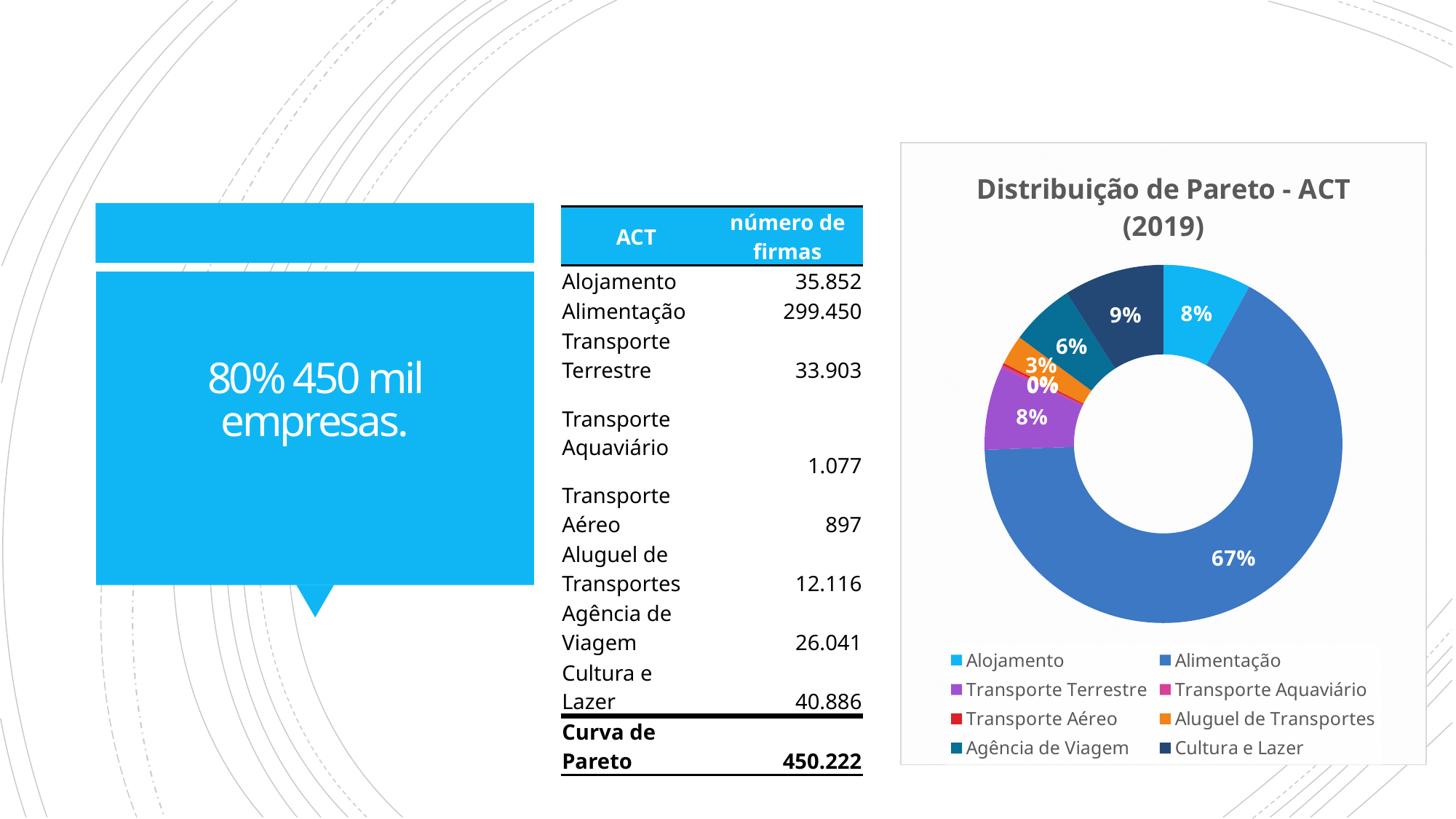
What share of the chart does Alojamento represent? 8% What share of the chart does Transporte Terrestre represent? 8% What is the difference in percentage points between the Alimentação slice and the Cultura e Lazer slice? 58 percentage points What share of the chart does Agência de Viagem represent? 6% How many categories does the chart's legend list? 8 Which category has the largest slice in the chart? Alimentação Which is larger in the chart, Cultura e Lazer or Agência de Viagem? Cultura e Lazer What kind of chart is shown on the slide? Pie chart (donut) What is the title of the chart? Distribuição de Pareto - ACT (2019)